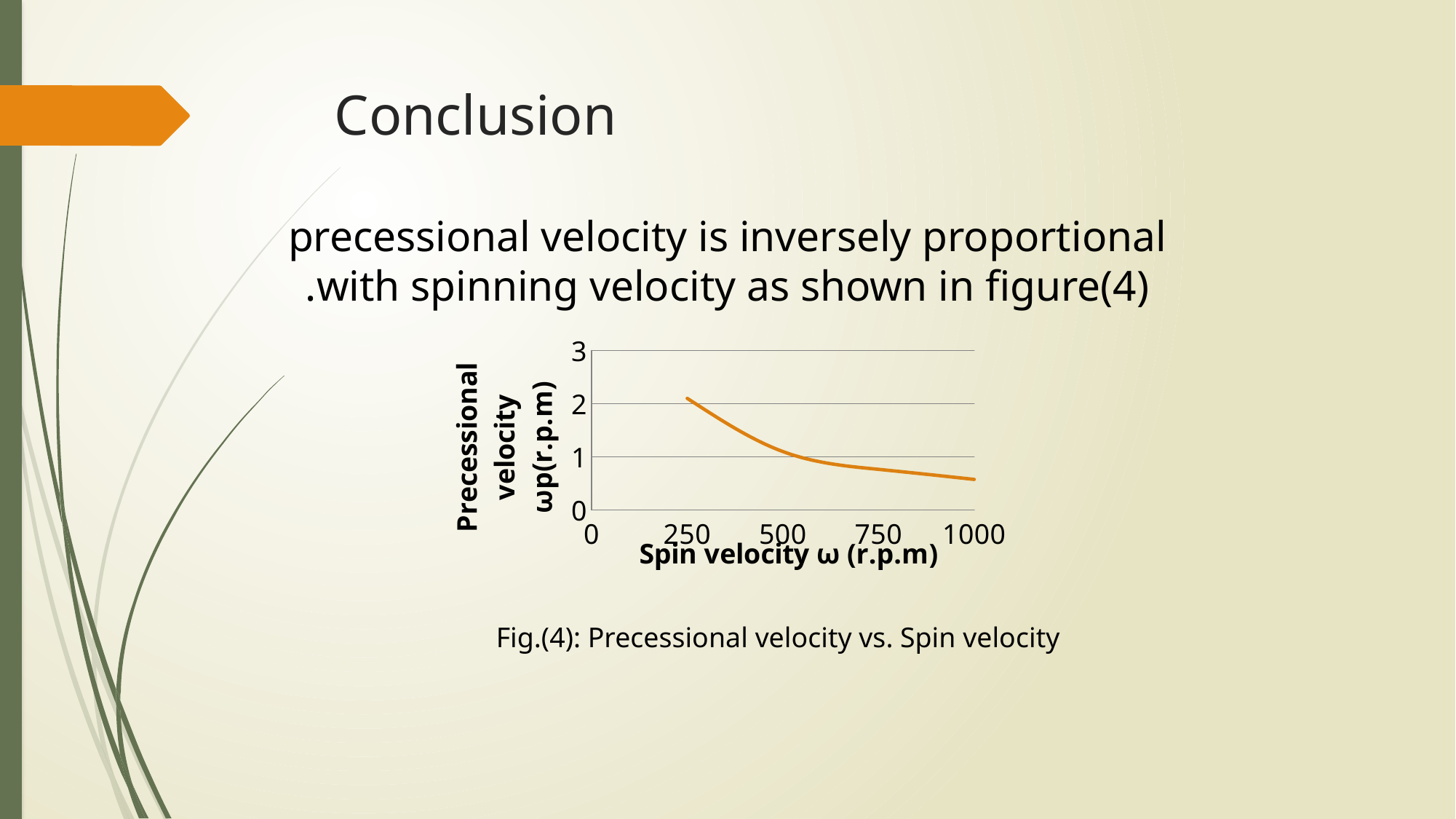
At which labelled spin velocity on the x axis is the precessional velocity highest? 250 What is the figure caption below the chart? Fig.(4): Precessional velocity vs. Spin velocity How many tick labels are shown on the x axis of the chart? 5 What is the title of the x axis of the chart? Spin velocity ω (r.p.m) Does the precessional velocity rise or fall as spin velocity increases along the x axis? fall At which labelled spin velocity on the x axis is the precessional velocity lowest? 1000 Is the precessional velocity at a spin velocity of 250 r.p.m greater or less than 1? greater Which is larger, the precessional velocity at a spin velocity of 250 r.p.m or at 1000 r.p.m? 250 r.p.m Is the precessional velocity at a spin velocity of 250 r.p.m greater or less than 3? less Is the precessional velocity at a spin velocity of 1000 r.p.m greater or less than 1? less What kind of chart is shown on the slide? line chart